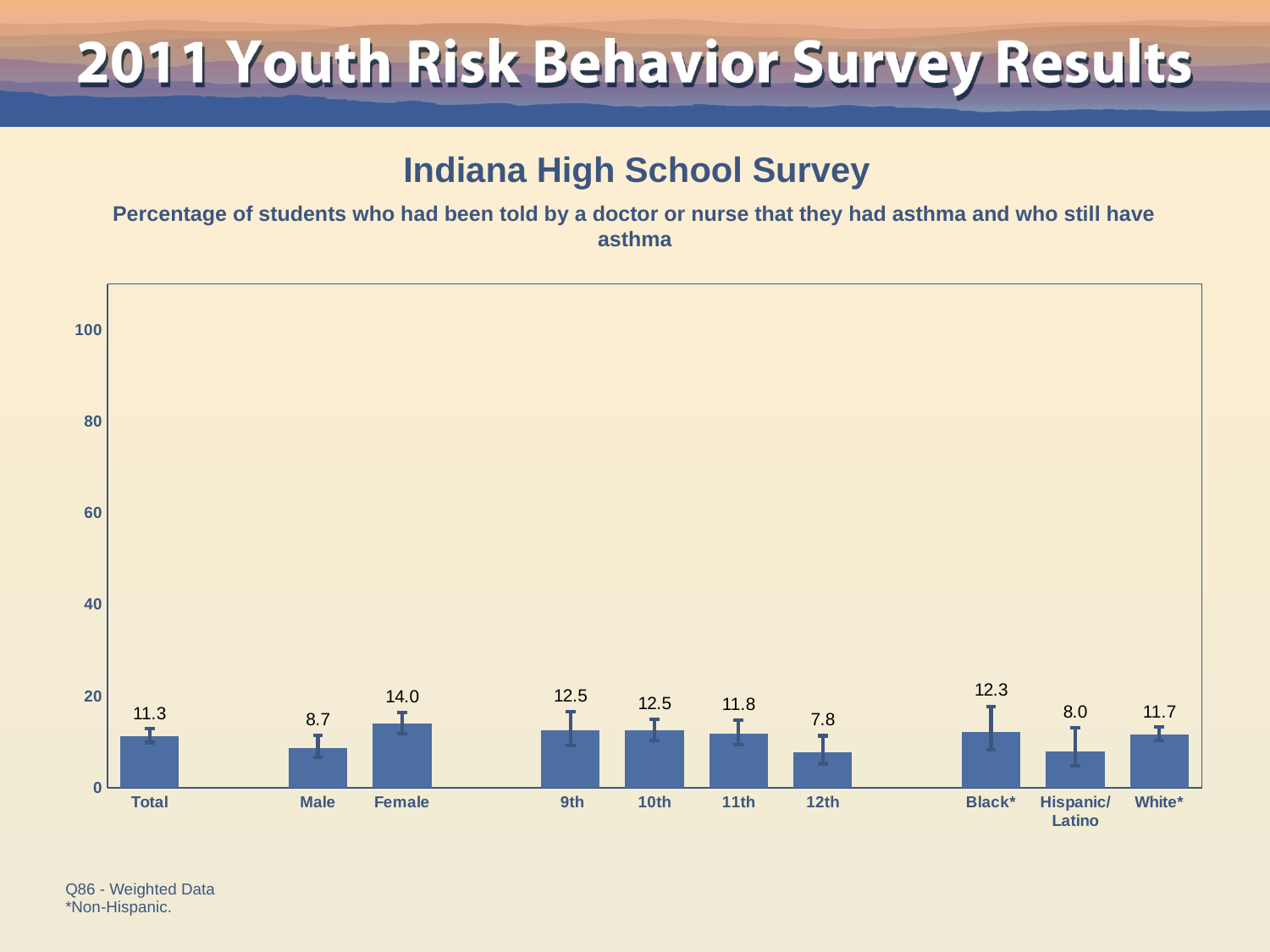
What is the value for Total? 11.3 What is the value for 12th? 7.8 What kind of chart is this? bar chart What is the difference between the values for Female and Male? 5.3 Which is larger, the value for Black* or the value for White*? Black* What is the value for Female? 14.0 Is the value for 9th greater or less than 20? less What is the value for Hispanic/Latino? 8.0 Do the values rise or fall from 9th to 12th grade? fall How many categories are shown on the x axis? 10 Which category has the lowest value? 12th Which category has the highest value? Female